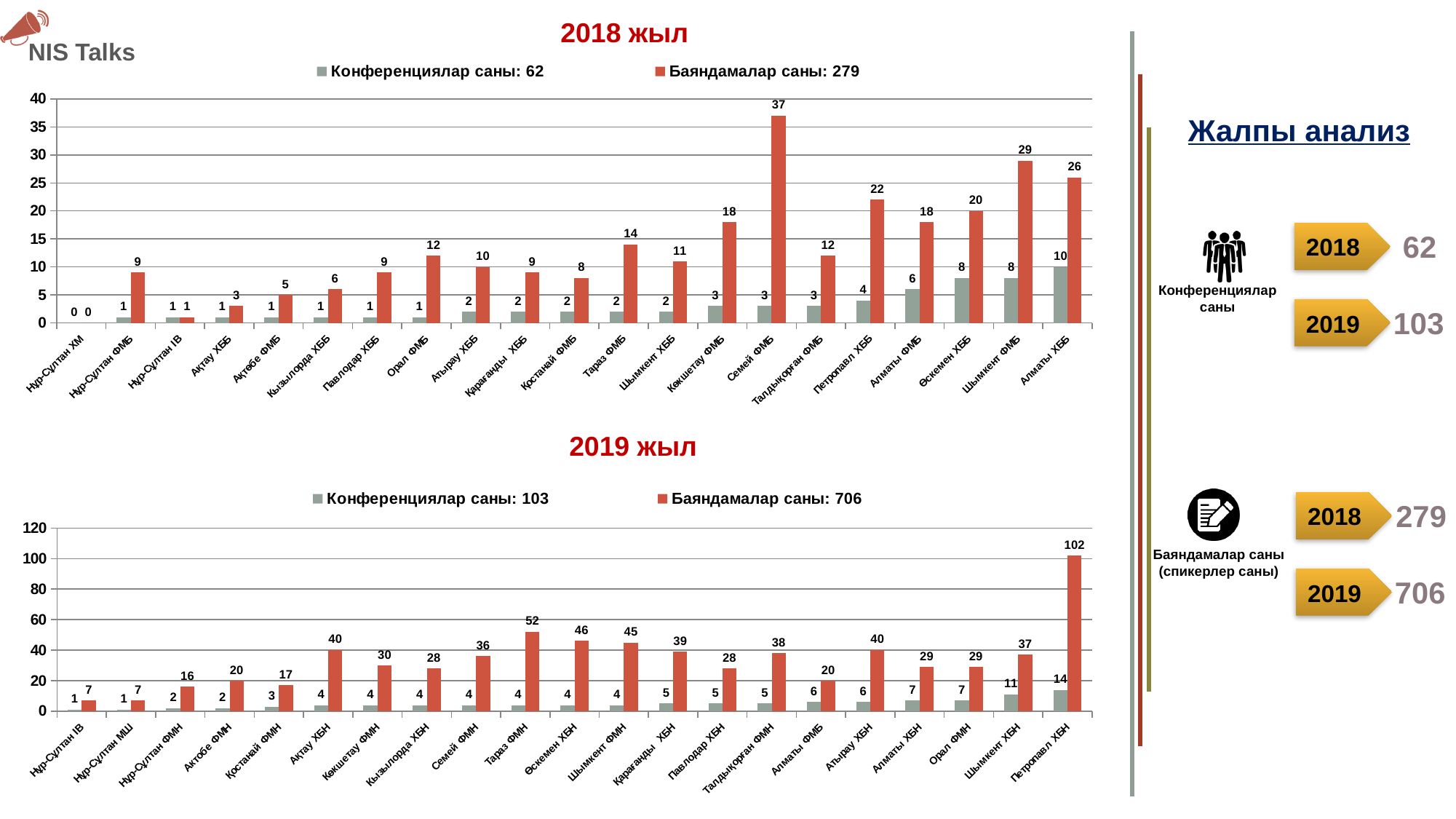
In the 2018 жыл chart, what is the Баяндамалар саны value for Семей ФМБ? 37 In the 2019 жыл chart, what is the Баяндамалар саны value for Петропавл ХБН? 102 In the 2019 жыл chart, which is larger, the Баяндамалар саны for Тараз ФМН or for Өскемен ХБН? Тараз ФМН In the 2018 жыл chart, how many series does the legend list? 2 In the 2018 жыл chart, which category has the highest Баяндамалар саны? Семей ФМБ In the 2019 жыл chart, what is the difference between the Баяндамалар саны for Петропавл ХБН and Тараз ФМН? 50 What type of chart is the 2019 жыл chart? Bar chart In the 2019 жыл chart, which category has the highest Баяндамалар саны? Петропавл ХБН In the 2019 жыл chart, what is the Конференциялар саны value for Шымкент ХБН? 11 According to the 2019 жыл chart legend, what is the total Баяндамалар саны? 706 In the 2018 жыл chart, which category has the highest Конференциялар саны? Алматы ХББ In the 2018 жыл chart, what is the difference between the Баяндамалар саны for Шымкент ФМБ and Алматы ХББ? 3